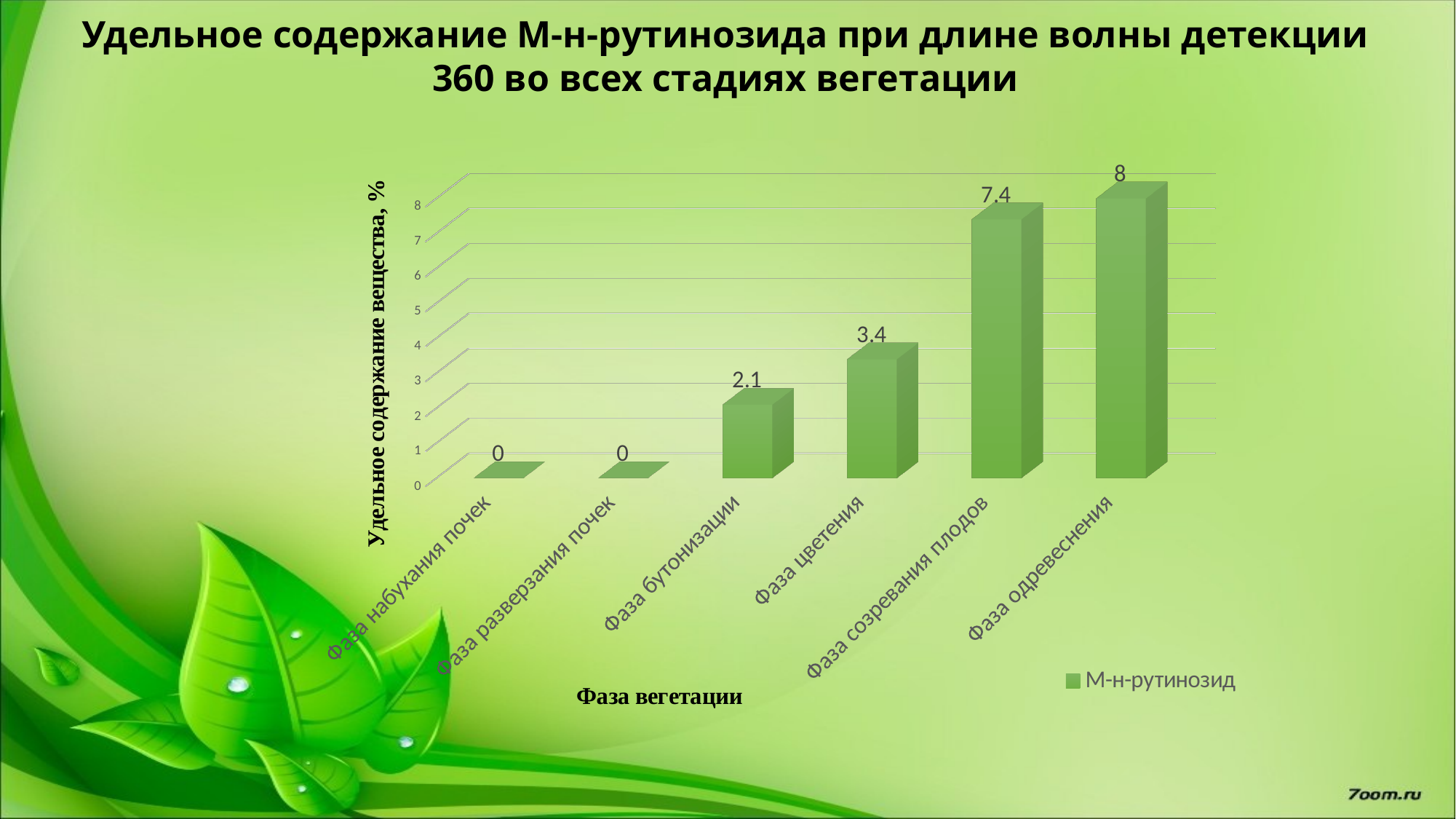
What is the difference between the values for Фаза одревеснения and Фаза созревания плодов? 0.6 What is the value for Фаза бутонизации? 2.1 What is the value for Фаза созревания плодов? 7.4 How many series does the legend list? 1 What is the value for Фаза набухания почек? 0 What is the difference between the values for Фаза цветения and Фаза бутонизации? 1.3 What kind of chart is shown? bar chart Do the values rise or fall from left to right along the x axis? rise How many vegetation phases are shown on the x axis? 6 Which phase has the highest value? Фаза одревеснения Which is larger, the value for Фаза цветения or the value for Фаза бутонизации? Фаза цветения What is the value for Фаза цветения? 3.4